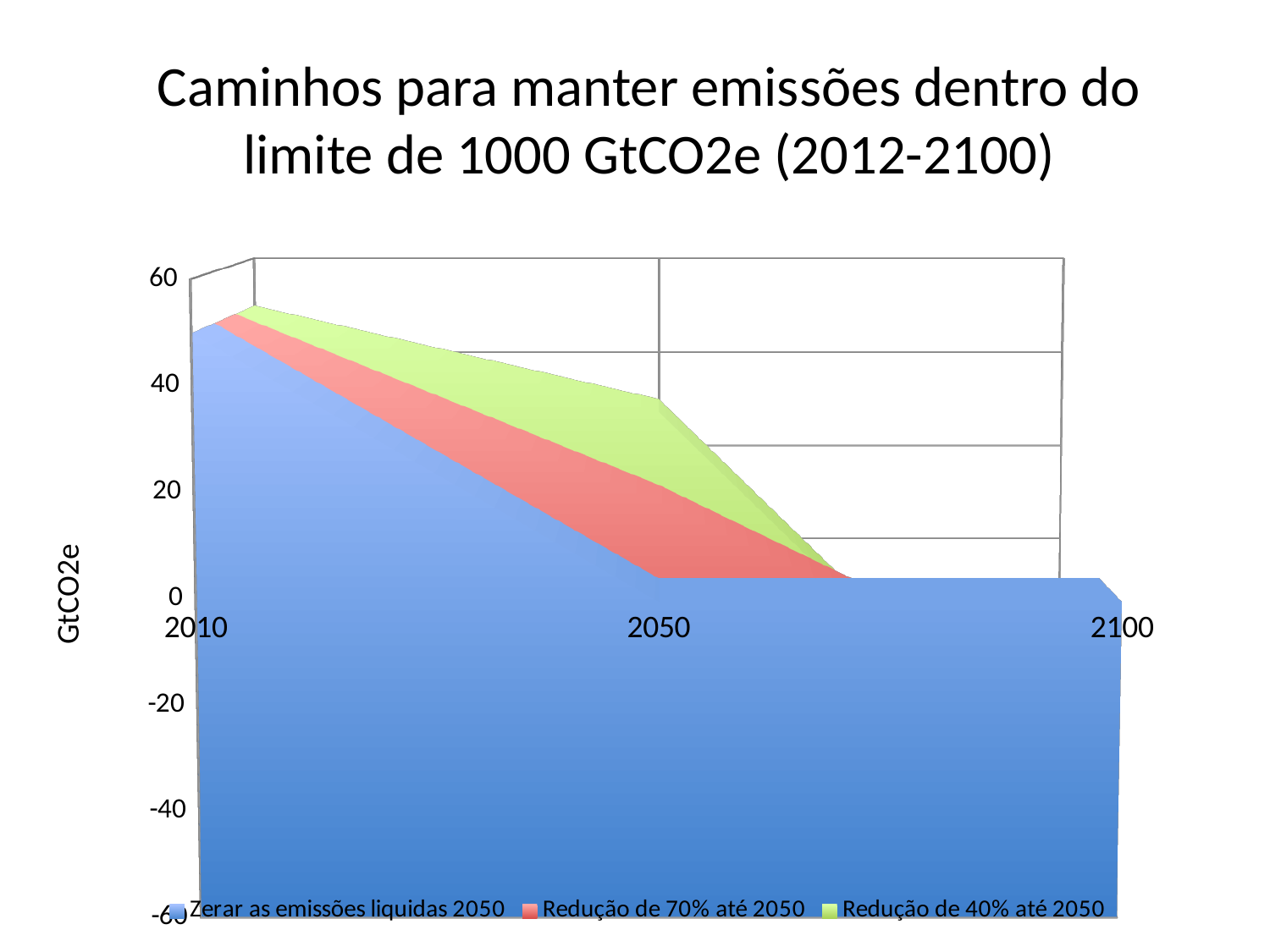
What kind of chart is shown on the slide? area chart What is the label on the vertical axis? GtCO2e Is the value for 'Zerar as emissões liquidas 2050' in 2050 greater or less than 20? less Is the value for 'Redução de 40% até 2050' in 2050 greater or less than 20? greater Is the value for 'Zerar as emissões liquidas 2050' in 2010 greater or less than 20? greater How many series does the legend list? 3 What is the title of the chart? Caminhos para manter emissões dentro do limite de 1000 GtCO2e (2012-2100) How many year labels are shown on the x axis? 3 In 2050, which series has the highest value? Redução de 40% até 2050 Do the values for 'Zerar as emissões liquidas 2050' rise or fall between 2010 and 2050? fall In 2050, which is larger: the value for 'Redução de 40% até 2050' or for 'Zerar as emissões liquidas 2050'? Redução de 40% até 2050